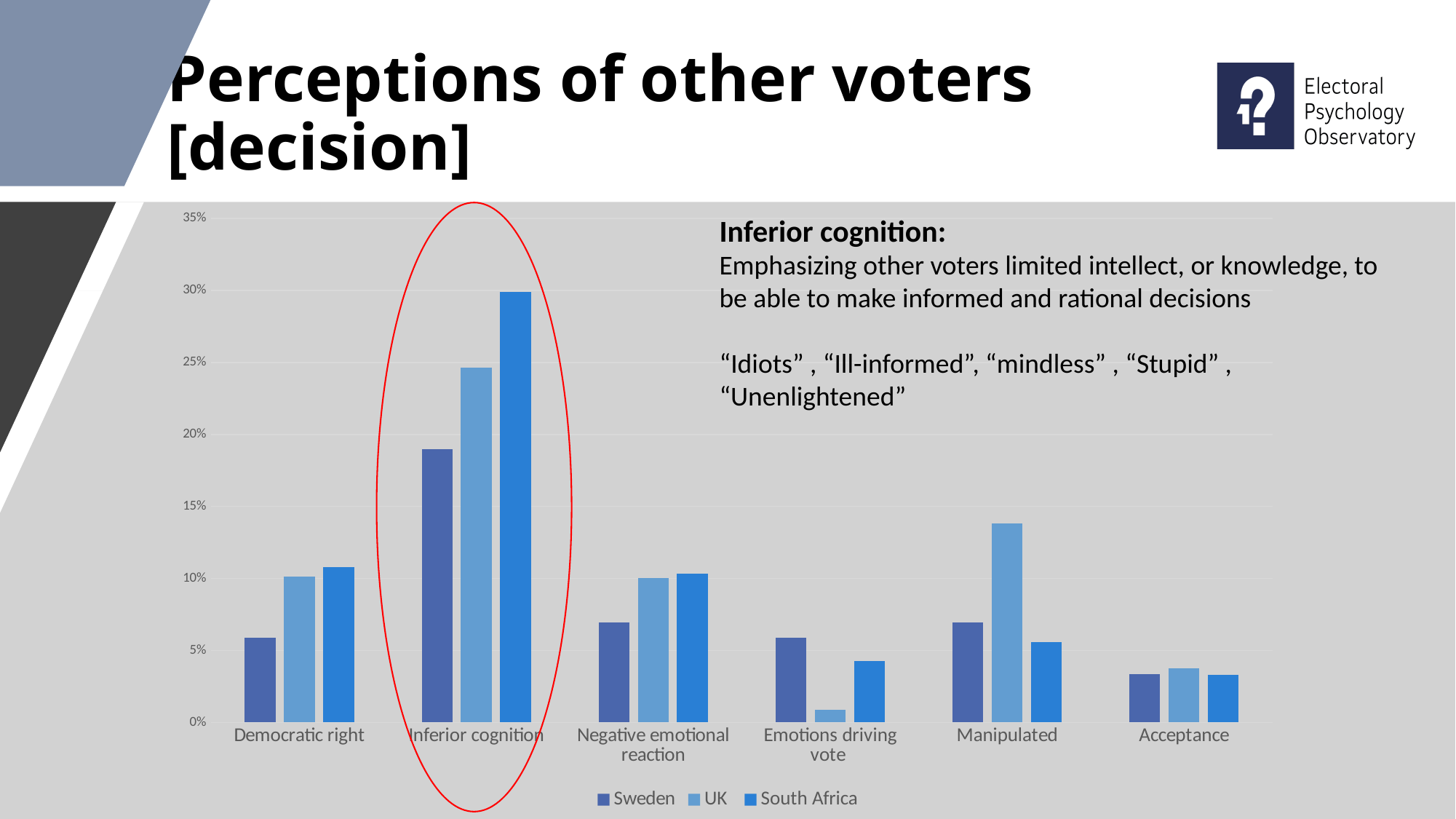
How many categories are shown on the x axis of the chart? 6 Is the value for UK in the Inferior cognition category greater or less than 20%? greater Which series has the lowest value in the Emotions driving vote category? UK Is the value for UK in the Manipulated category greater or less than 10%? greater In the Manipulated category, which is larger: the value for UK or the value for Sweden? UK Which category on the chart is circled in red? Inferior cognition How many series does the chart's legend list? 3 What kind of chart is shown on the slide? Bar chart Which series has the highest value in the Inferior cognition category? South Africa Is the value for Sweden in the Democratic right category greater or less than 10%? less Which category has the highest value for South Africa? Inferior cognition